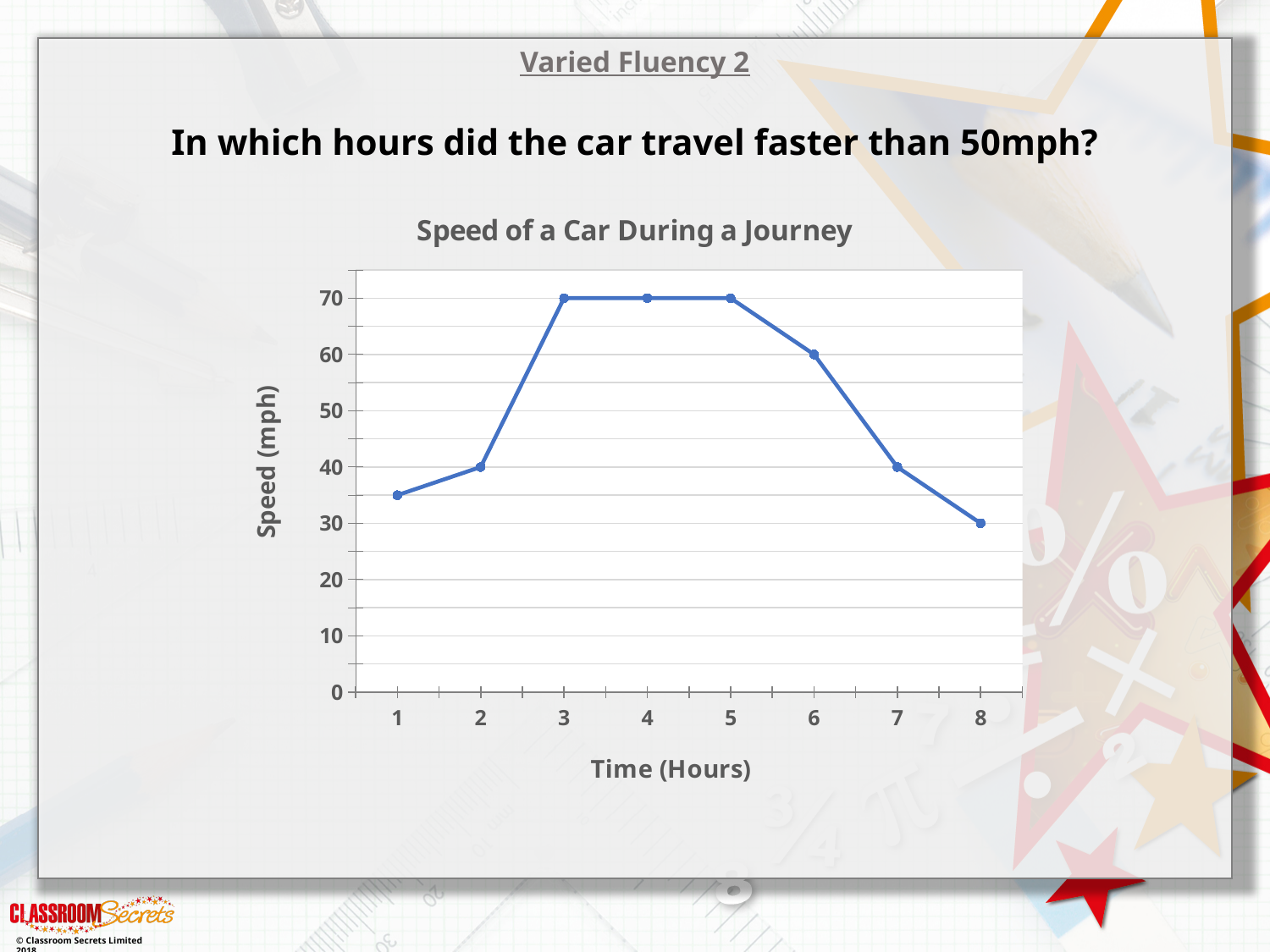
How many data points are plotted on the chart? 8 What is the difference between the speed at hour 6 and the speed at hour 7? 20 Does the speed rise or fall from hour 5 to hour 8? fall At which hour was the car's speed lowest? 8 What is the title of the chart? Speed of a Car During a Journey What was the speed of the car at hour 3? 70 What type of chart is shown on the slide? line chart What was the speed of the car at hour 6? 60 What was the speed of the car at hour 8? 30 What was the speed of the car at hour 2? 40 Is the speed at hour 1 greater or less than 40? less What is the label on the vertical axis of the chart? Speed (mph)